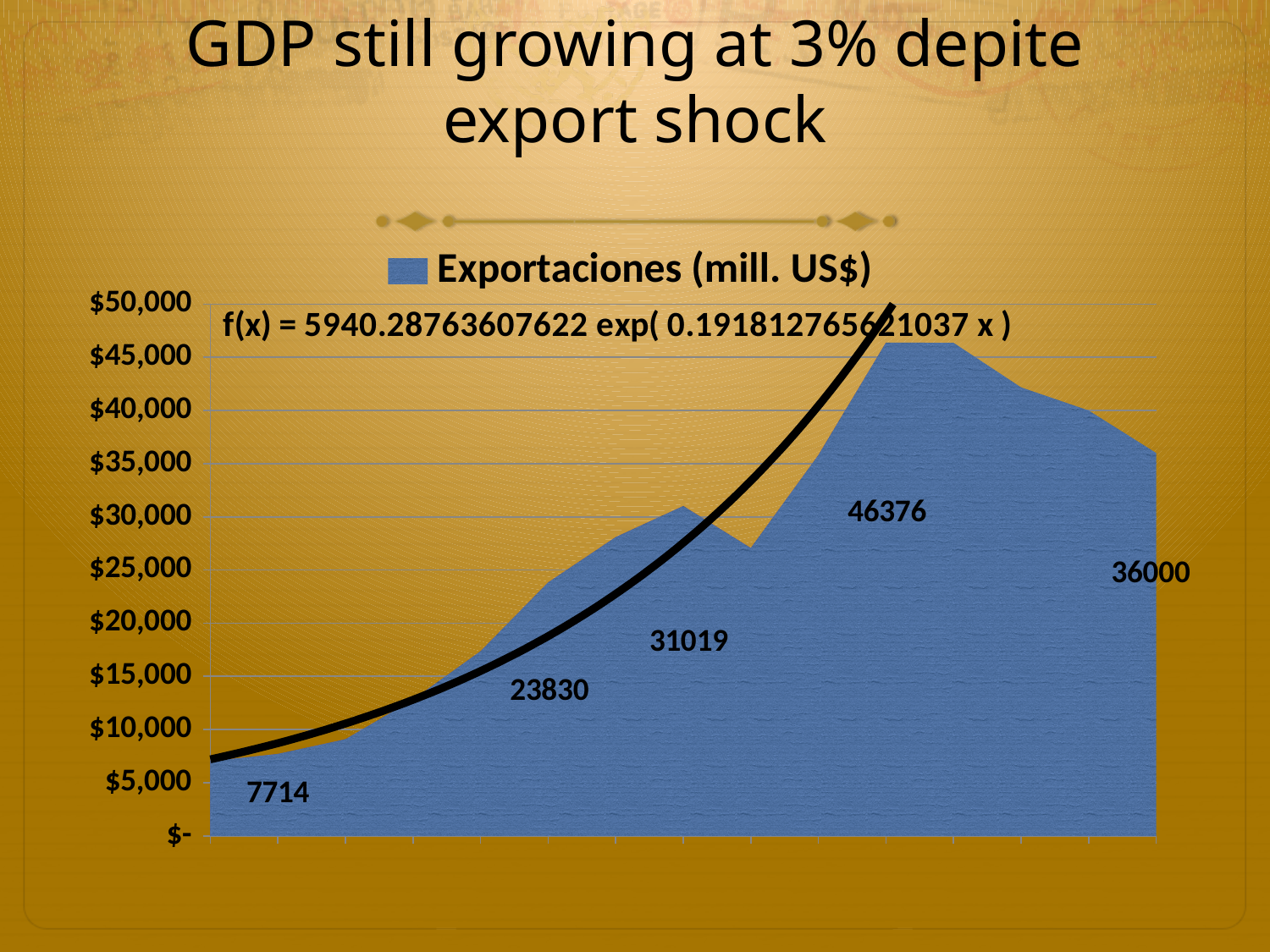
Do the values rise or fall from the peak to the right edge of the chart? fall Which is larger, the peak labelled value or the final labelled value at the right edge? 46376 What is the legend entry for the plotted series? Exportaciones (mill. US$) What is the difference between the labelled values 31019 and 23830? 7189 What is the difference between the highest labelled value (46376) and the lowest labelled value (7714)? 38662 What is the lowest data-labelled value on the chart? 7714 Is the peak value of the series greater or less than $45,000? greater What kind of chart is shown on the slide? area chart How many series does the legend list? 1 What is the highest data-labelled value on the chart? 46376 What is the constant coefficient in the fitted trendline equation f(x) shown on the chart? 5940.28763607622 What is the difference between the peak labelled value (46376) and the final labelled value (36000)? 10376